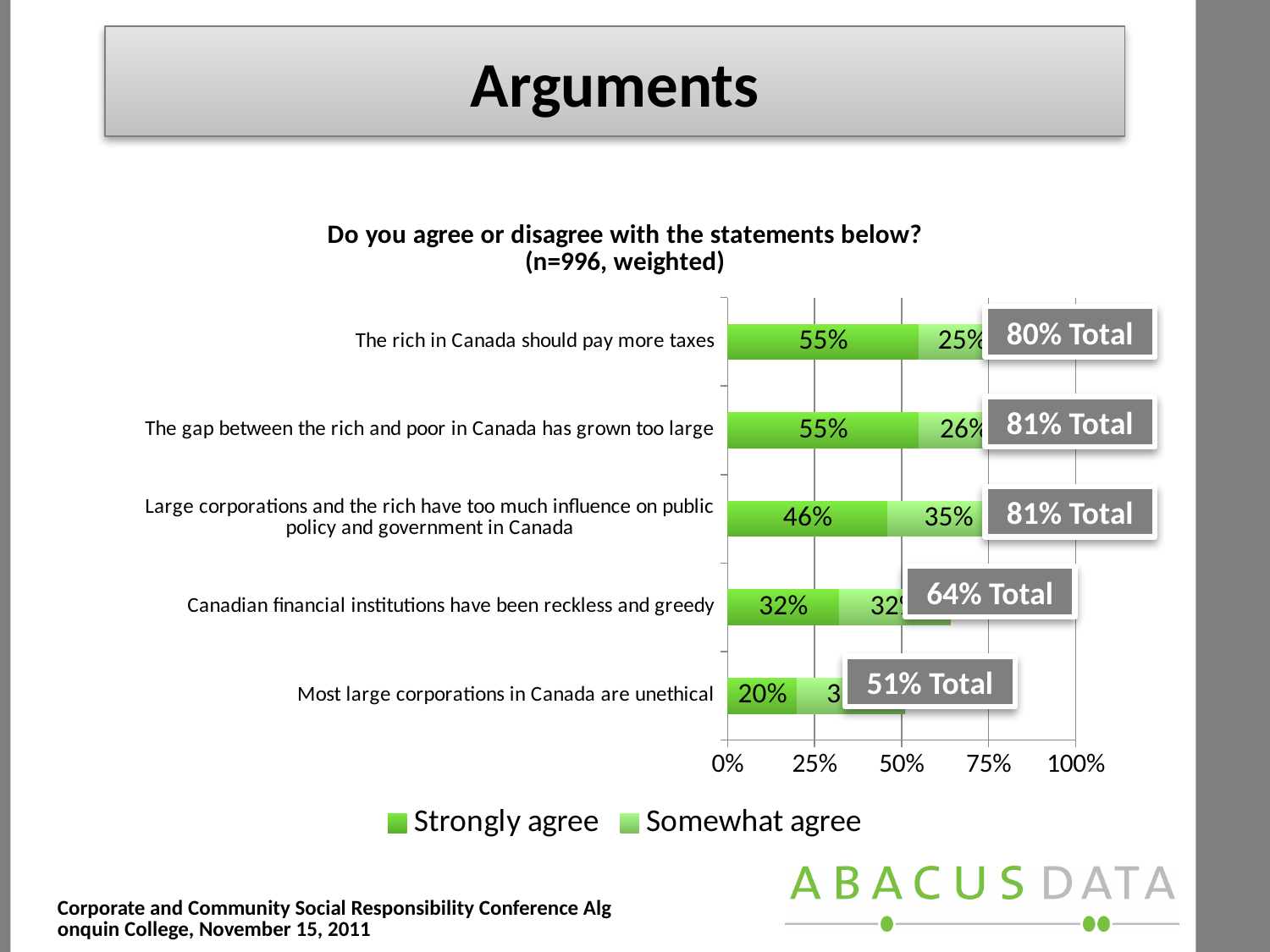
How many series does the legend list? 2 What percentage strongly agree that most large corporations in Canada are unethical? 20% What percentage strongly agree that the rich in Canada should pay more taxes? 55% Which statement has the highest 'Somewhat agree' percentage? Large corporations and the rich have too much influence on public policy and government in Canada What is the total agreement shown for the statement that Canadian financial institutions have been reckless and greedy? 64% What percentage somewhat agree that large corporations and the rich have too much influence on public policy and government in Canada? 35% How many percentage points higher is the 'Strongly agree' share for 'The gap between the rich and poor in Canada has grown too large' than for 'Large corporations and the rich have too much influence on public policy and government in Canada'? 9 percentage points Which statement has the lowest total agreement? Most large corporations in Canada are unethical What percentage somewhat agree that the gap between the rich and poor in Canada has grown too large? 26% Which statement has a larger 'Strongly agree' share: 'Canadian financial institutions have been reckless and greedy' or 'Most large corporations in Canada are unethical'? Canadian financial institutions have been reckless and greedy What kind of chart is shown on the slide? bar chart How many statements are shown in the chart? 5